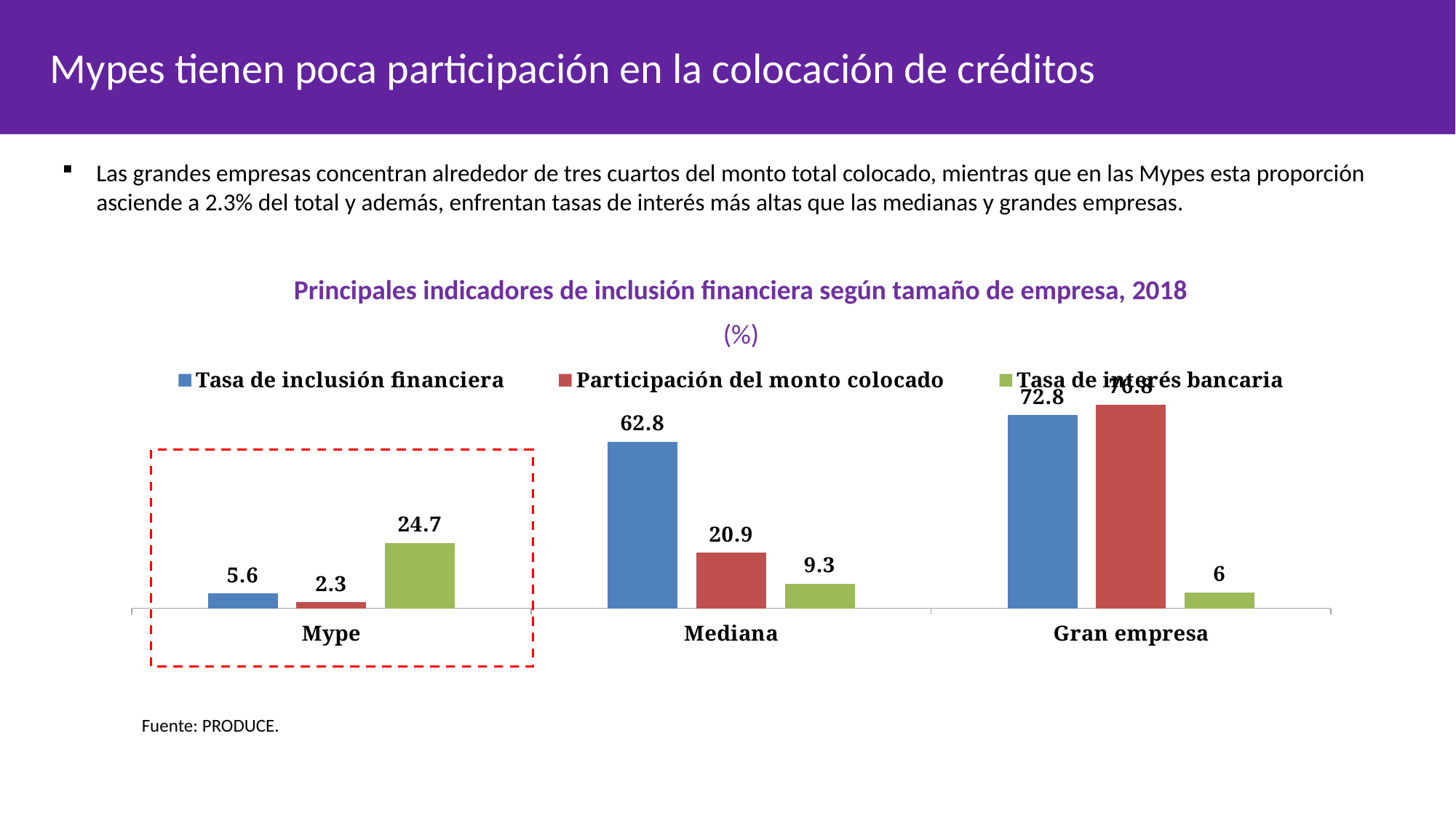
What is the Participación del monto colocado for Mype? 2.3 What is the Tasa de inclusión financiera for Mype? 5.6 What is the Tasa de inclusión financiera for Gran empresa? 72.8 How many series does the chart legend list? 3 Which is larger for Mype: the Tasa de interés bancaria or the Participación del monto colocado? Tasa de interés bancaria What is the title of the chart? Principales indicadores de inclusión financiera según tamaño de empresa, 2018 (%) What is the Tasa de interés bancaria for Mediana? 9.3 What is the difference between the Tasa de inclusión financiera for Mediana and for Mype? 57.2 What type of chart is shown on the slide? Bar chart Which category has the lowest Tasa de interés bancaria? Gran empresa Which category has the highest Tasa de inclusión financiera? Gran empresa How many company-size categories are shown on the x axis? 3